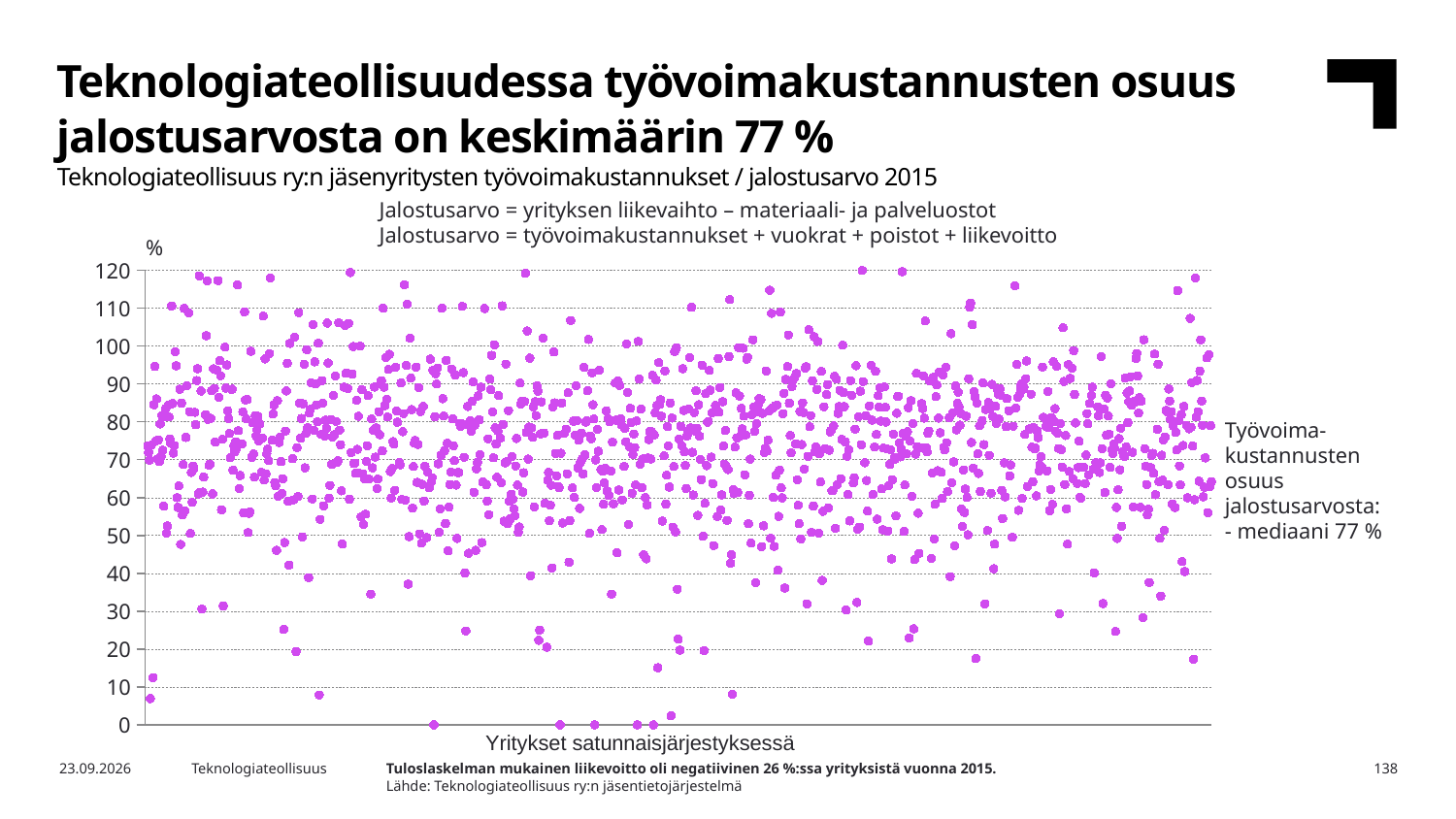
What is the highest value shown on the y axis of the chart? 120 According to the annotation on the chart, what is the median share of labour costs in value added? 77 % Do the plotted values show a clear rising or falling trend along the x axis? no clear trend What is the label of the x axis of the chart? Yritykset satunnaisjärjestyksessä What kind of chart is shown on the slide? scatter chart